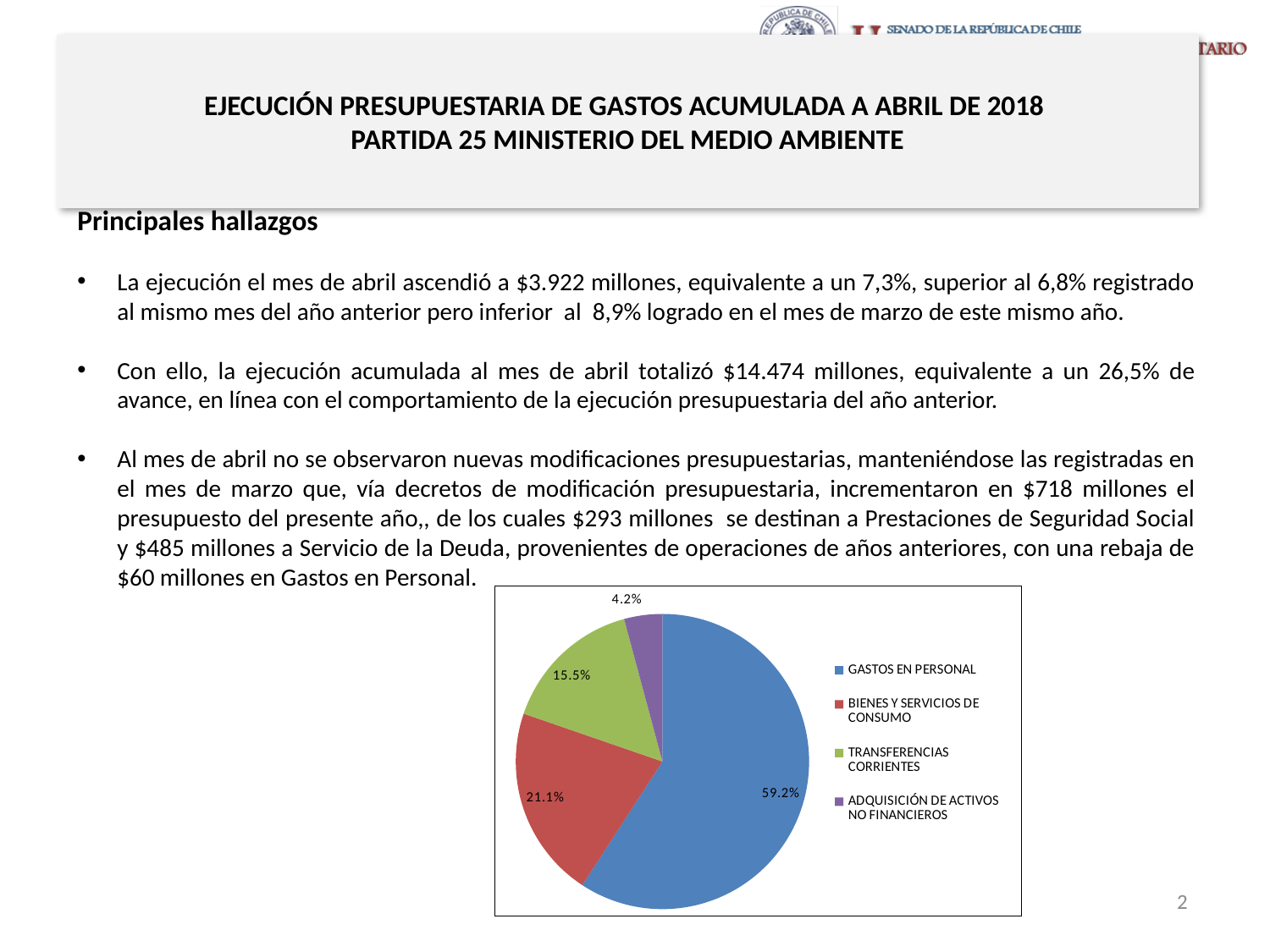
Which slice is larger, TRANSFERENCIAS CORRIENTES or BIENES Y SERVICIOS DE CONSUMO? BIENES Y SERVICIOS DE CONSUMO Which category has the smallest slice of the pie? ADQUISICIÓN DE ACTIVOS NO FINANCIEROS How many categories does the pie chart show? 4 Which category has the largest slice of the pie? GASTOS EN PERSONAL What share of the pie does ADQUISICIÓN DE ACTIVOS NO FINANCIEROS represent? 4.2% What share of the pie does TRANSFERENCIAS CORRIENTES represent? 15.5% What share of the pie does GASTOS EN PERSONAL represent? 59.2% What is the difference in percentage points between the GASTOS EN PERSONAL slice and the BIENES Y SERVICIOS DE CONSUMO slice? 38.1 What kind of chart is shown on the slide? pie chart What colour is the TRANSFERENCIAS CORRIENTES slice? green What colour is the GASTOS EN PERSONAL slice? blue